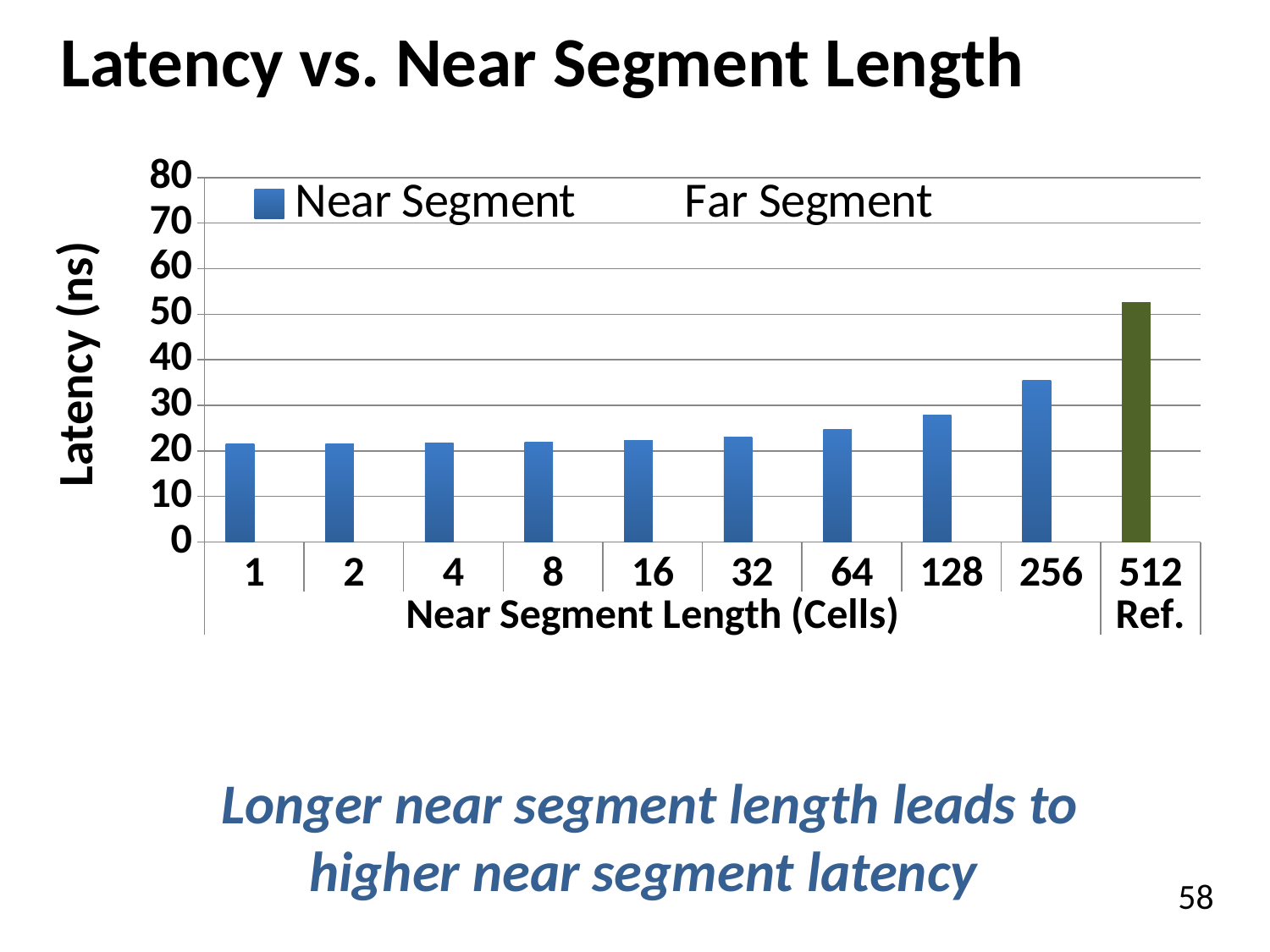
How many categories are shown along the x axis of the chart? 10 Is the latency for near segment length 128 greater or less than 40? less What is the title of the chart's x axis? Near Segment Length (Cells) Do the Near Segment latency values rise or fall as the near segment length increases along the x axis? rise Which has a higher latency: near segment length 256 or near segment length 128? 256 Is the latency for near segment length 256 greater or less than 30? greater How many series does the chart's legend list? 2 Is the latency for the 512 Ref. bar greater or less than 40? greater What is the title of the chart's y axis? Latency (ns) What kind of chart is shown on the slide? bar chart Which category has the highest latency in the chart? 512 Ref.